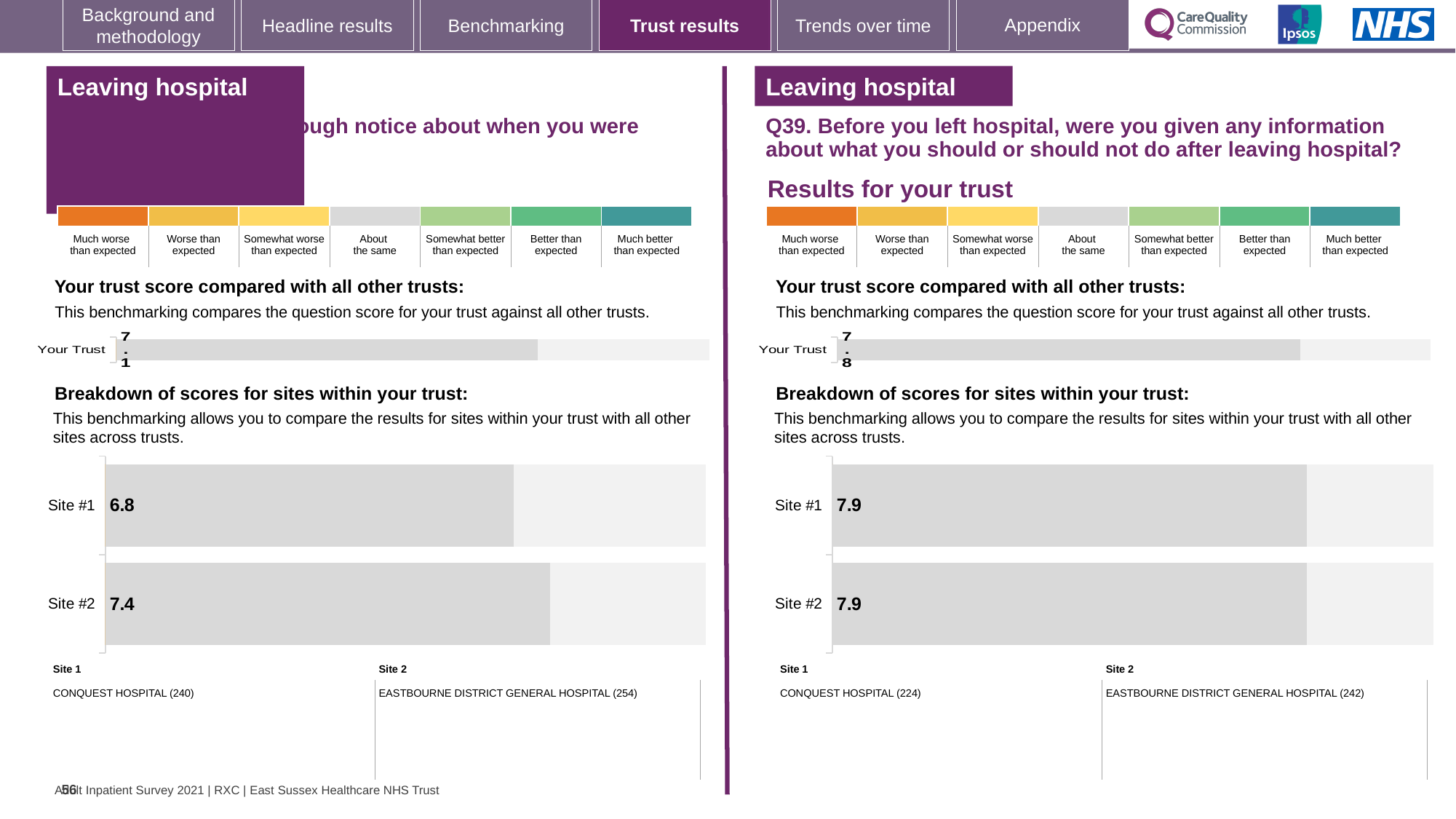
On the left-hand side of the slide, which site has the higher score in the site breakdown chart? Site #2 Is the Site #1 score on the left-hand side of the slide larger or smaller than the Site #1 score for Q39 on the right-hand side? Smaller On the left-hand side of the slide, what is the difference between the Site #2 and Site #1 scores in the site breakdown chart? 0.6 For Q39 on the right-hand side of the slide, which hospital is listed as Site 2 below the site breakdown chart? EASTBOURNE DISTRICT GENERAL HOSPITAL (242) For Q39 on the right-hand side of the slide, what is the 'Your Trust' score in the trust score comparison chart? 7.8 On the left-hand side of the slide, what is the 'Your Trust' score in the trust score comparison chart? 7.1 What kind of chart is used for the breakdown of scores for sites within your trust on the left-hand side of the slide? Bar chart On the left-hand side of the slide, what is the score shown for Site #2 in the breakdown of scores for sites within your trust? 7.4 For Q39 on the right-hand side of the slide, what is the score shown for Site #2 in the site breakdown chart? 7.9 On the left-hand side of the slide, what is the score shown for Site #1 in the breakdown of scores for sites within your trust? 6.8 For Q39 on the right-hand side of the slide, how many sites are shown in the site breakdown chart? 2 For Q39 on the right-hand side of the slide, what is the score shown for Site #1 in the site breakdown chart? 7.9